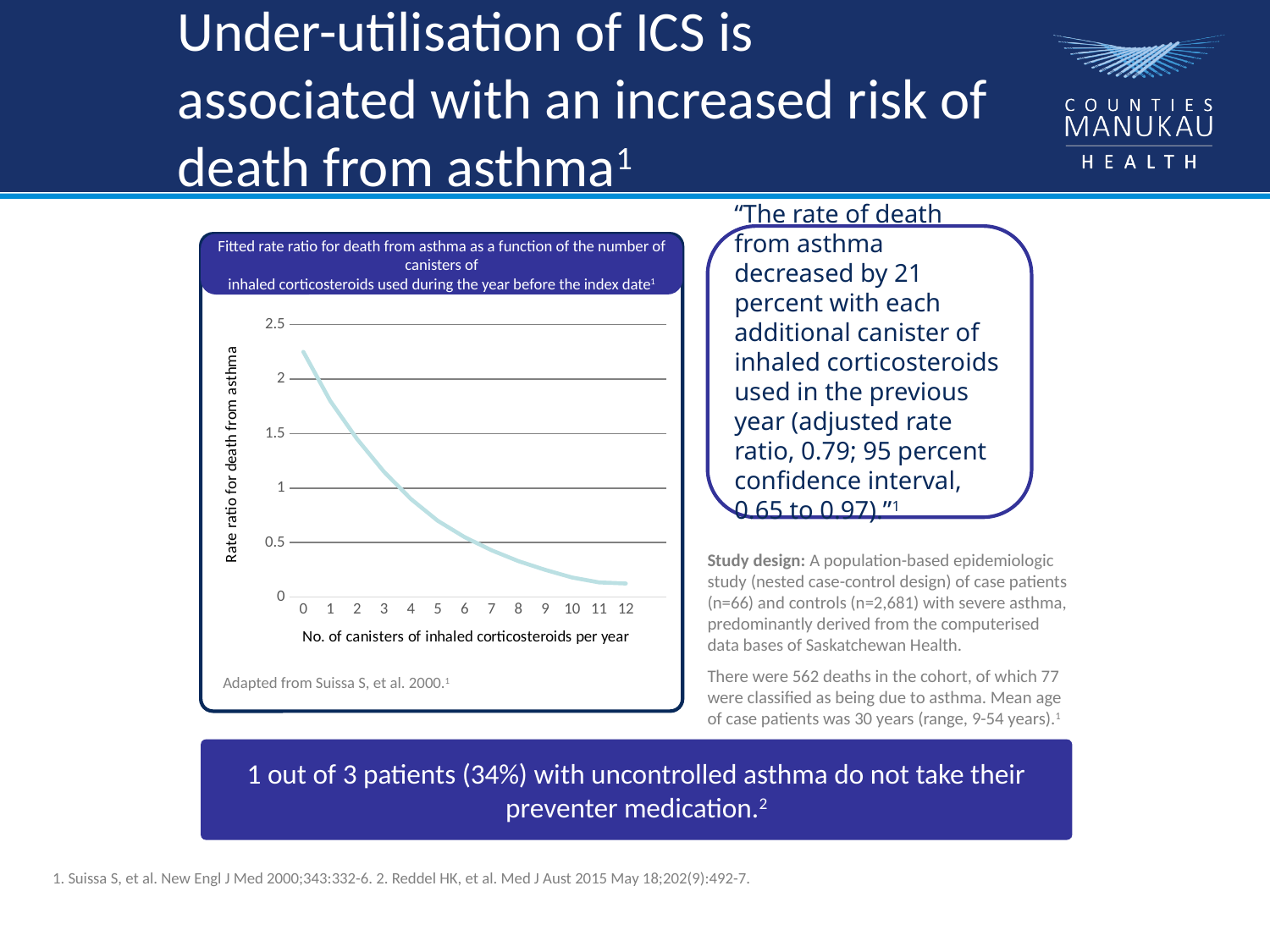
What is the label of the x axis of the chart? No. of canisters of inhaled corticosteroids per year Is the rate ratio for death from asthma at 3 canisters per year greater or less than 1.5? less Is the rate ratio for death from asthma at 12 canisters per year greater or less than 0.5? less What kind of chart is shown on the slide? line chart Is the rate ratio for death from asthma at 0 canisters per year larger or smaller than at 6 canisters per year? larger At which number of canisters per year is the rate ratio for death from asthma highest? 0 At which number of canisters per year is the rate ratio for death from asthma lowest? 12 What is the label of the y axis of the chart? Rate ratio for death from asthma How many tick values are shown on the x axis of the chart? 13 Does the rate ratio for death from asthma rise or fall as the number of canisters of inhaled corticosteroids per year increases? fall Is the rate ratio for death from asthma at 0 canisters per year greater or less than 2? greater